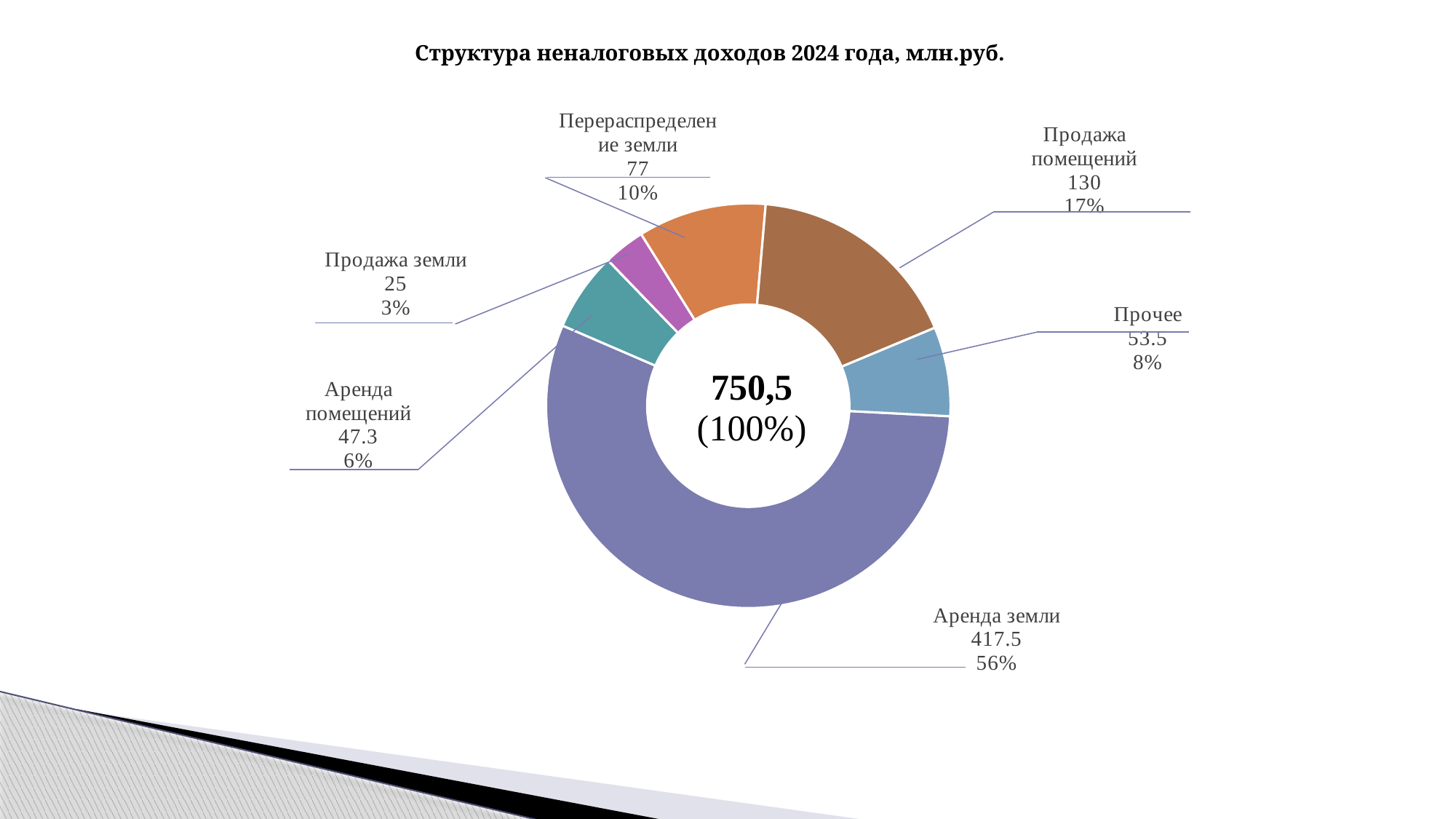
Which is larger, Перераспределение земли or Аренда помещений? Перераспределение земли What is the value for Прочее? 53.5 What share of the total does Аренда помещений represent? 6% What is the value for Продажа помещений? 130 What total value is shown in the centre of the chart? 750,5 How many categories are shown in the chart? 6 What is the value for Аренда земли? 417.5 Which category has the smallest share? Продажа земли Which category has the largest share? Аренда земли What is the difference between the values for Продажа помещений and Прочее? 76.5 What is the value for Перераспределение земли? 77 What share of the total does Продажа помещений represent? 17%